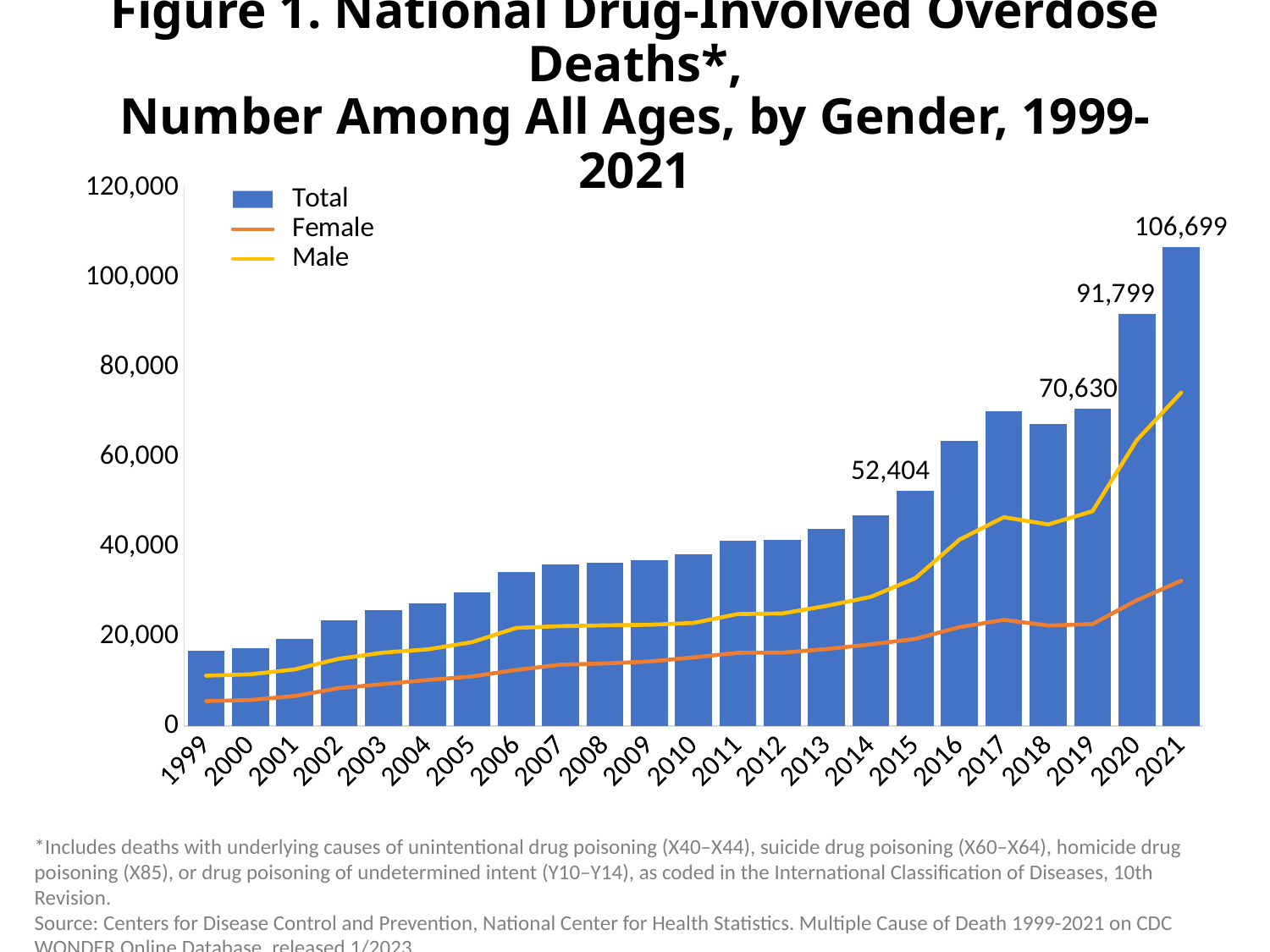
Which year has the highest Total number of deaths? 2021 What is the Total number of drug-involved overdose deaths in 2020? 91,799 How many years are shown on the x axis? 23 What is the Total number of drug-involved overdose deaths in 2021? 106,699 In 2021, which is higher, the Male line or the Female line? Male Is the Total number of deaths in 2016 greater or less than 60,000? greater What is the Total number of drug-involved overdose deaths in 2015? 52,404 Is the Total number of deaths in 1999 greater or less than 20,000? less By how much did the Total number of deaths increase from 2020 to 2021? 14,900 How many series does the legend list? 3